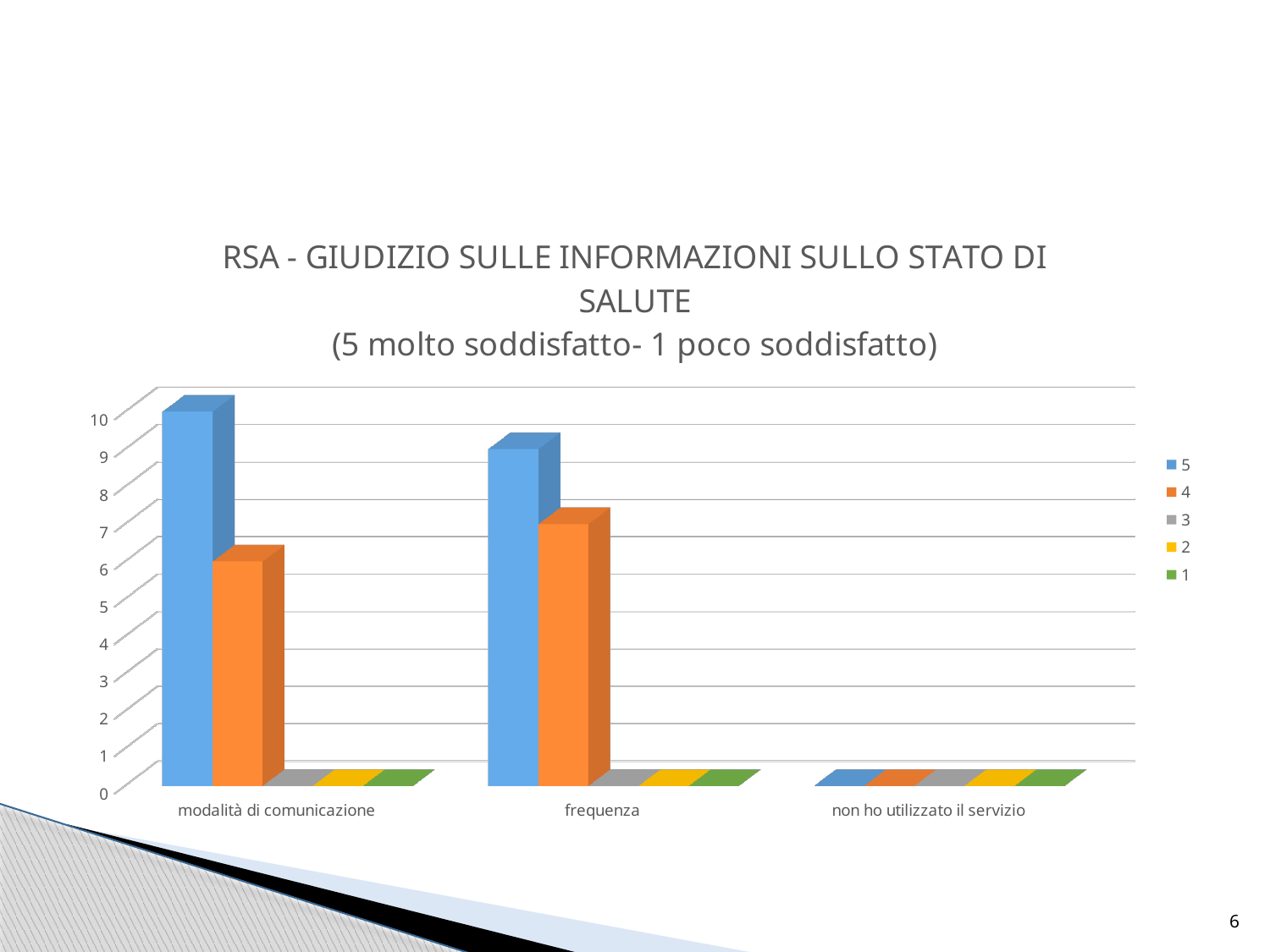
Is the value for series 4 in the category frequenza greater or less than 5? greater What colour are the bars for series 4 in the chart? orange Is the value for series 4 in the category modalità di comunicazione greater or less than 8? less How many series does the legend of the chart list? 5 Which category has the highest value for series 5? modalità di comunicazione Do the values for series 5 rise or fall moving from modalità di comunicazione to non ho utilizzato il servizio along the x axis? fall Is the value for series 5 in the category modalità di comunicazione greater or less than 8? greater For the category modalità di comunicazione, which is larger: the value for series 5 or the value for series 4? series 5 Which category has the lowest value for series 4? non ho utilizzato il servizio What kind of chart is shown on the slide? bar chart How many categories are shown on the x axis of the chart? 3